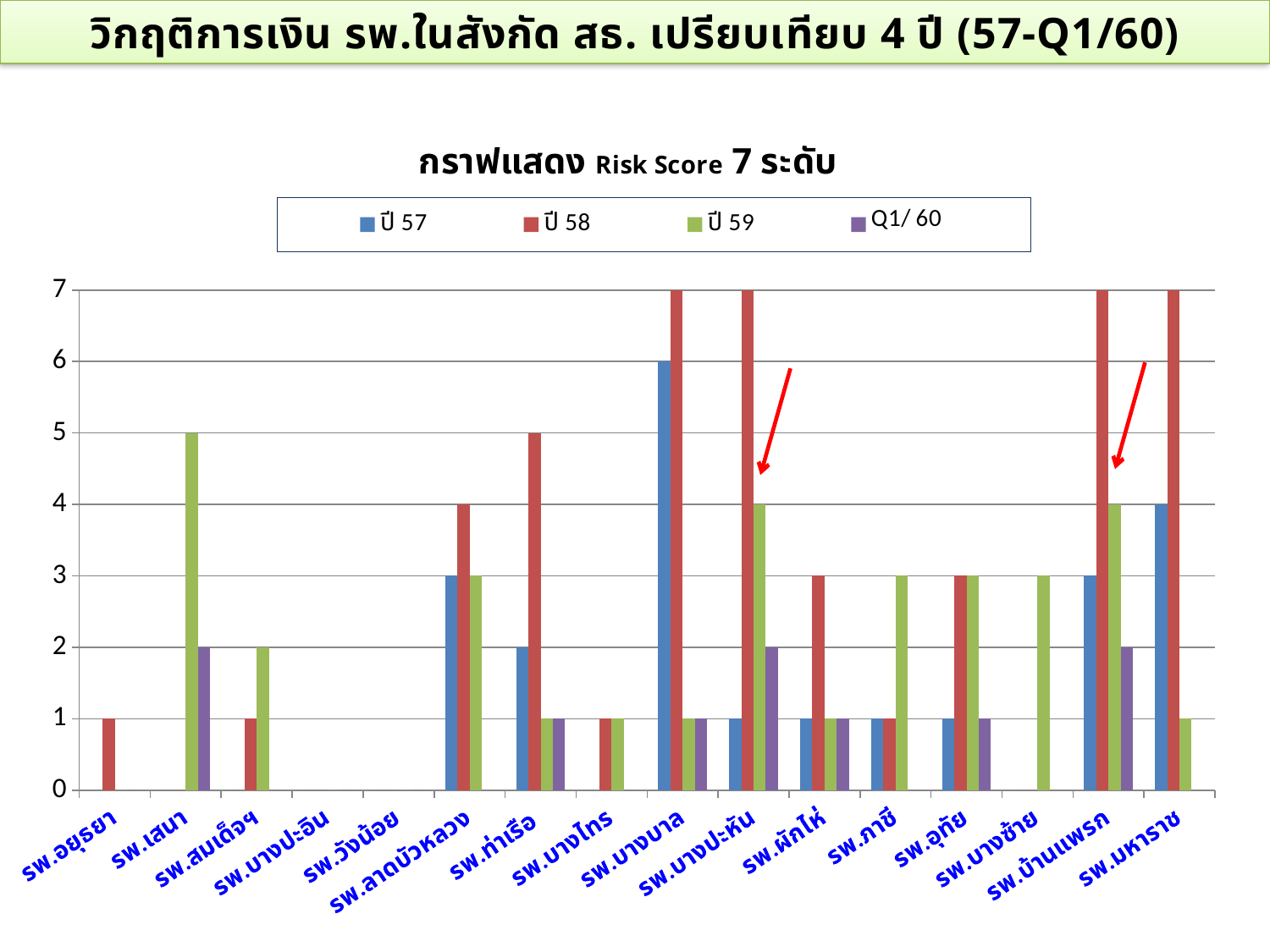
Which hospital has the highest ปี 57 value? รพ.บางบาล What is the ปี 57 value for รพ.บางบาล? 6 Which is larger for รพ.มหาราช, the ปี 57 value or the ปี 59 value? ปี 57 How many hospitals (categories) are shown on the x axis? 16 What is the Q1/ 60 value for รพ.บางปะหัน? 2 What is the title of the chart? กราฟแสดง Risk Score 7 ระดับ How many series does the legend list? 4 Is the ปี 58 value for รพ.ลาดบัวหลวง greater or less than 2? greater What is the ปี 58 value for รพ.ท่าเรือ? 5 What is the difference between the ปี 58 and ปี 59 values for รพ.บ้านแพรก? 3 What is the ปี 59 value for รพ.เสนา? 5 What kind of chart is shown on the slide? bar chart